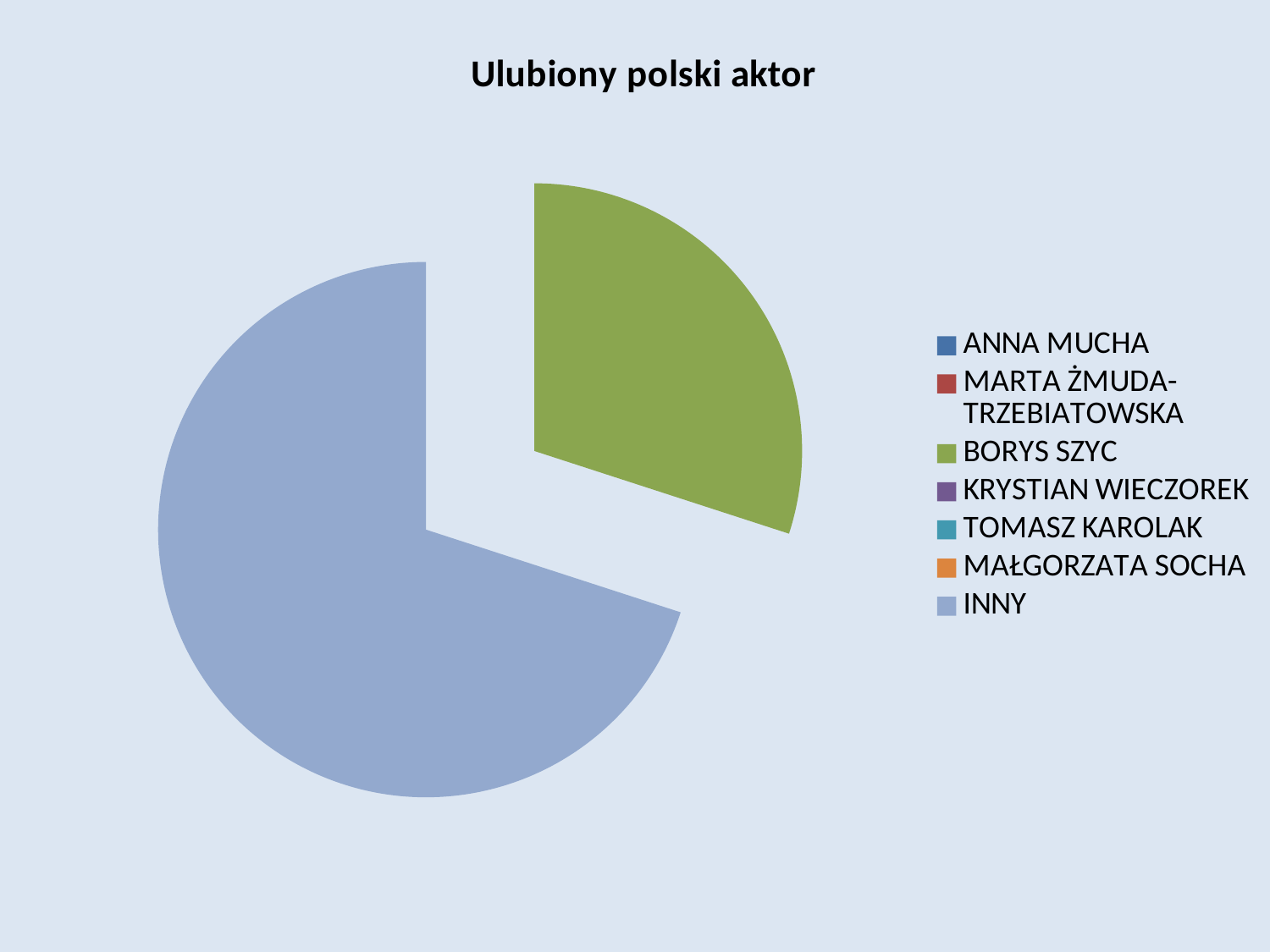
How many slices are visible in the pie chart? 2 Which category is shown by the green slice? BORYS SZYC What kind of chart is shown on the slide? pie chart Which slice is larger, BORYS SZYC or INNY? INNY Of the two visible slices, which category has the smaller one? BORYS SZYC Which category has the largest slice of the pie? INNY What is the title of the chart? Ulubiony polski aktor How many entries does the chart's legend list? 7